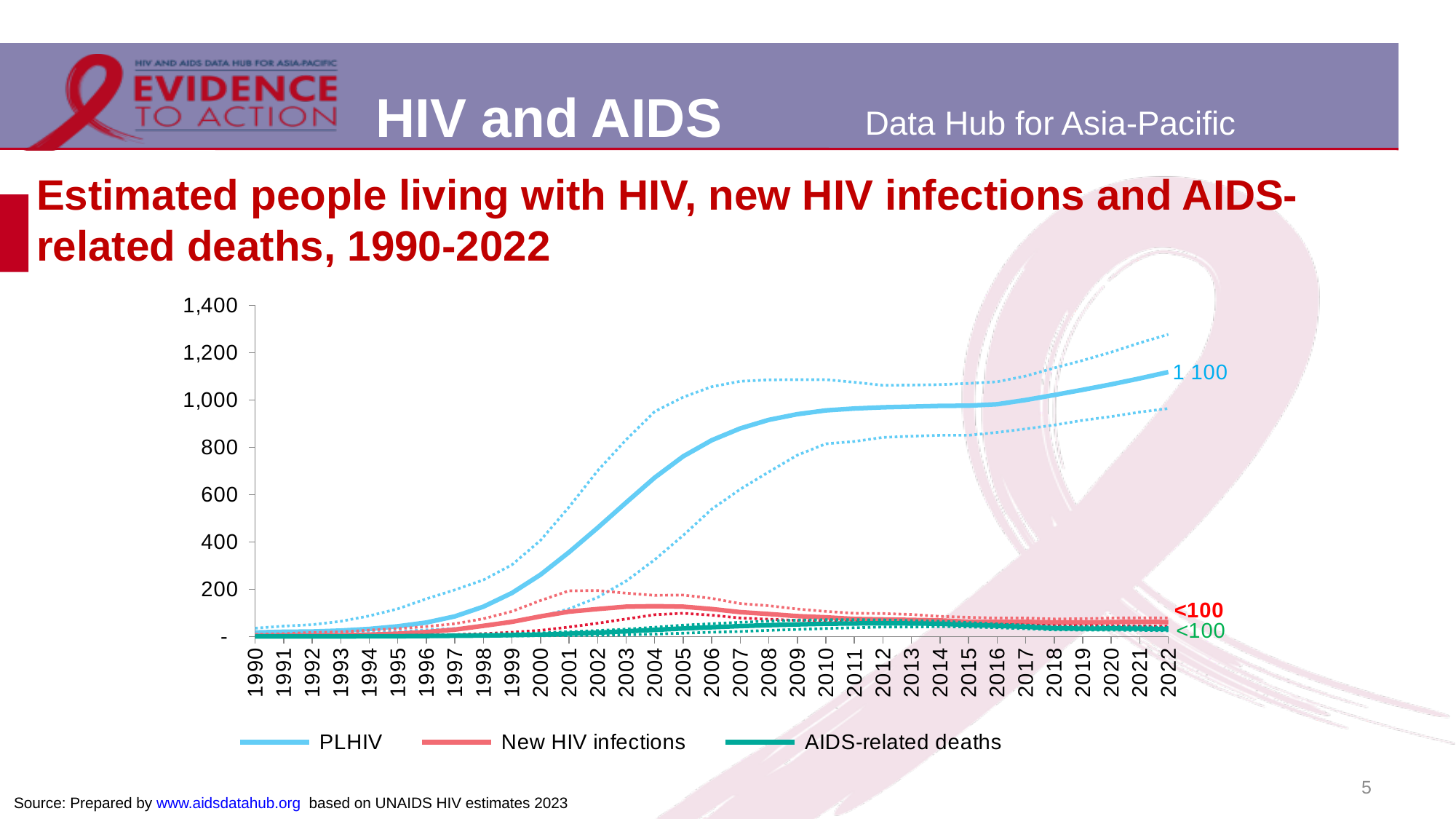
What kind of chart is shown on the slide? line chart What is the labelled value for PLHIV in 2022? 1 100 How many years are shown on the x axis? 33 Which series has the highest value in 2022? PLHIV What is the labelled value for AIDS-related deaths in 2022? <100 What colour is the PLHIV line in the legend? blue Is the value for PLHIV in 2000 greater or less than 600? less What is the labelled value for New HIV infections in 2022? <100 How many series does the legend list? 3 Does the PLHIV line rise or fall from 1990 to 2022? rises Is the value for PLHIV in 2010 greater or less than 800? greater Is the value for PLHIV in 2022 greater or less than 1,000? greater